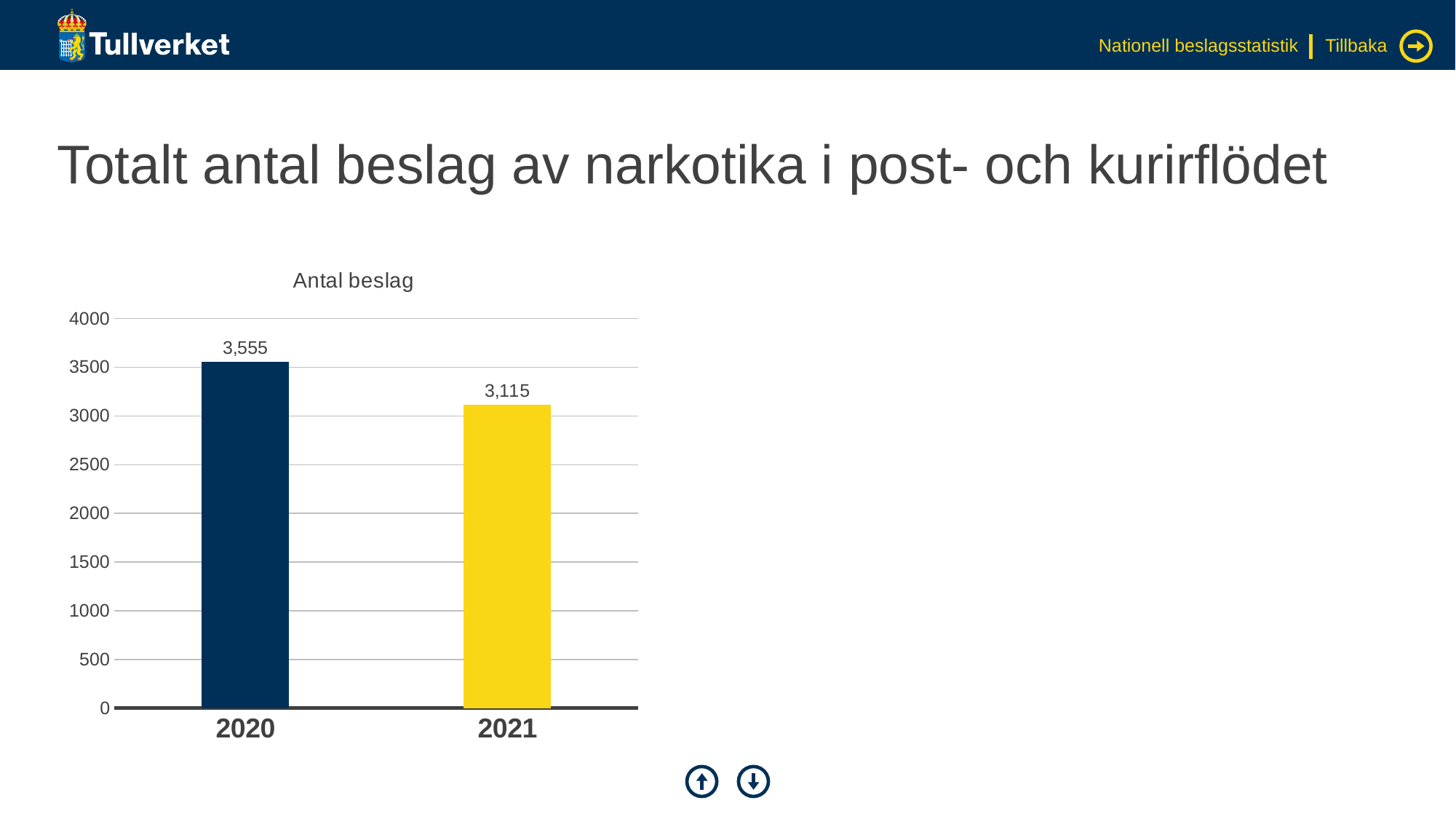
Is the value for 2021 greater or less than 3500? less Which year has the highest number of seizures? 2020 What is the title of the chart? Antal beslag How many years are shown on the x axis? 2 What is the value for 2021? 3,115 Which is larger, the value for 2020 or the value for 2021? 2020 What is the difference between the values for 2020 and 2021? 440 What kind of chart is shown on the slide? bar chart Is the value for 2020 greater or less than 3000? greater Do the values rise or fall from 2020 to 2021? fall What is the value for 2020? 3,555 Which year has the lowest number of seizures? 2021